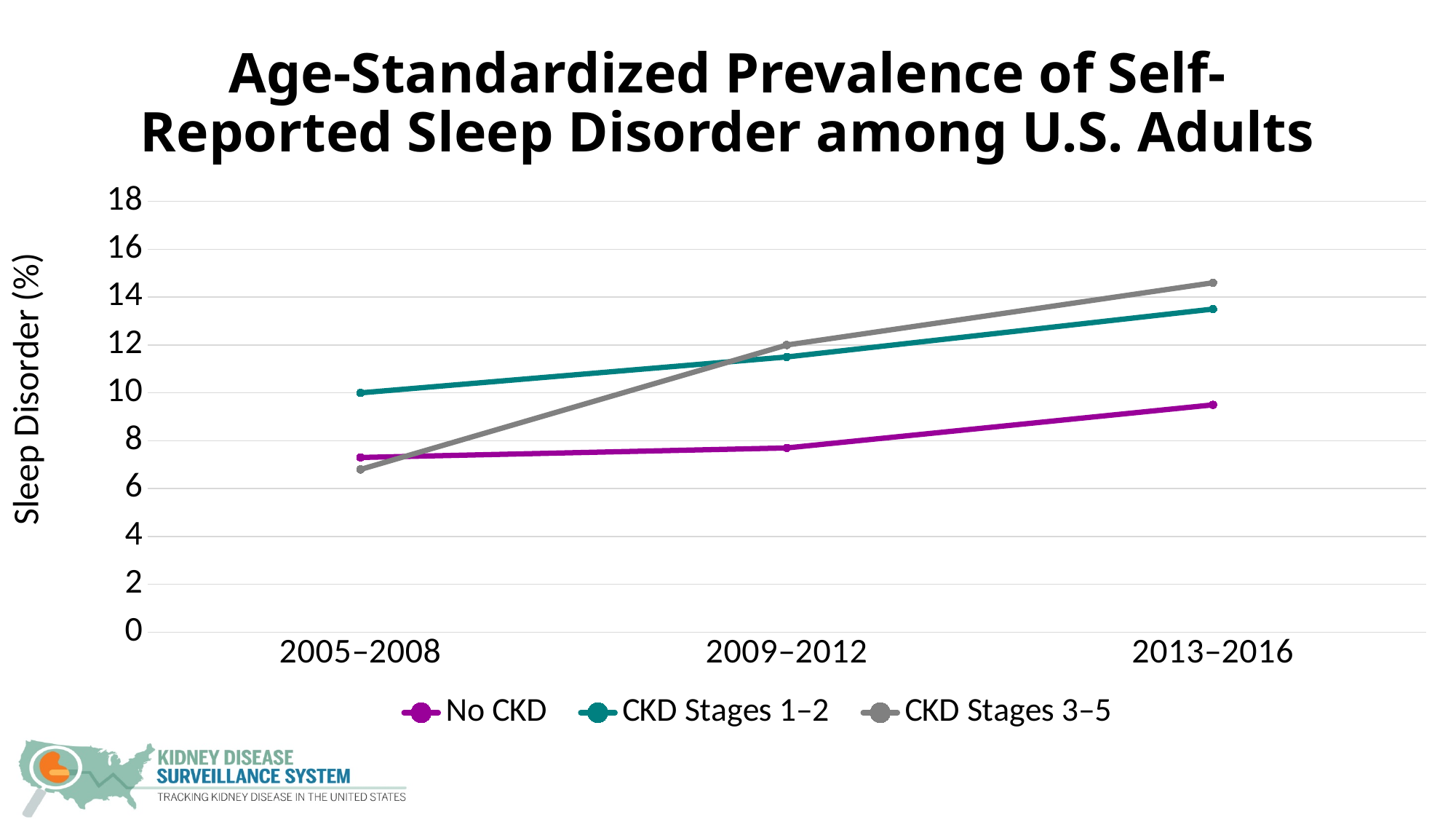
What is the label of the y axis? Sleep Disorder (%) Is the value for CKD Stages 3–5 in 2013–2016 greater or less than 14? greater How many time periods are shown on the x axis? 3 Which series has the lowest value in 2005–2008? CKD Stages 3–5 Is the value for No CKD in 2009–2012 greater or less than 8? less Does the value for CKD Stages 3–5 rise or fall from 2005–2008 to 2013–2016? rise Which series has the highest value in 2013–2016? CKD Stages 3–5 Which series has the lowest value in 2013–2016? No CKD What kind of chart is shown on the slide? line chart Which series has the highest value in 2005–2008? CKD Stages 1–2 In 2005–2008, which is larger: the value for No CKD or the value for CKD Stages 1–2? CKD Stages 1–2 How many series does the legend list? 3